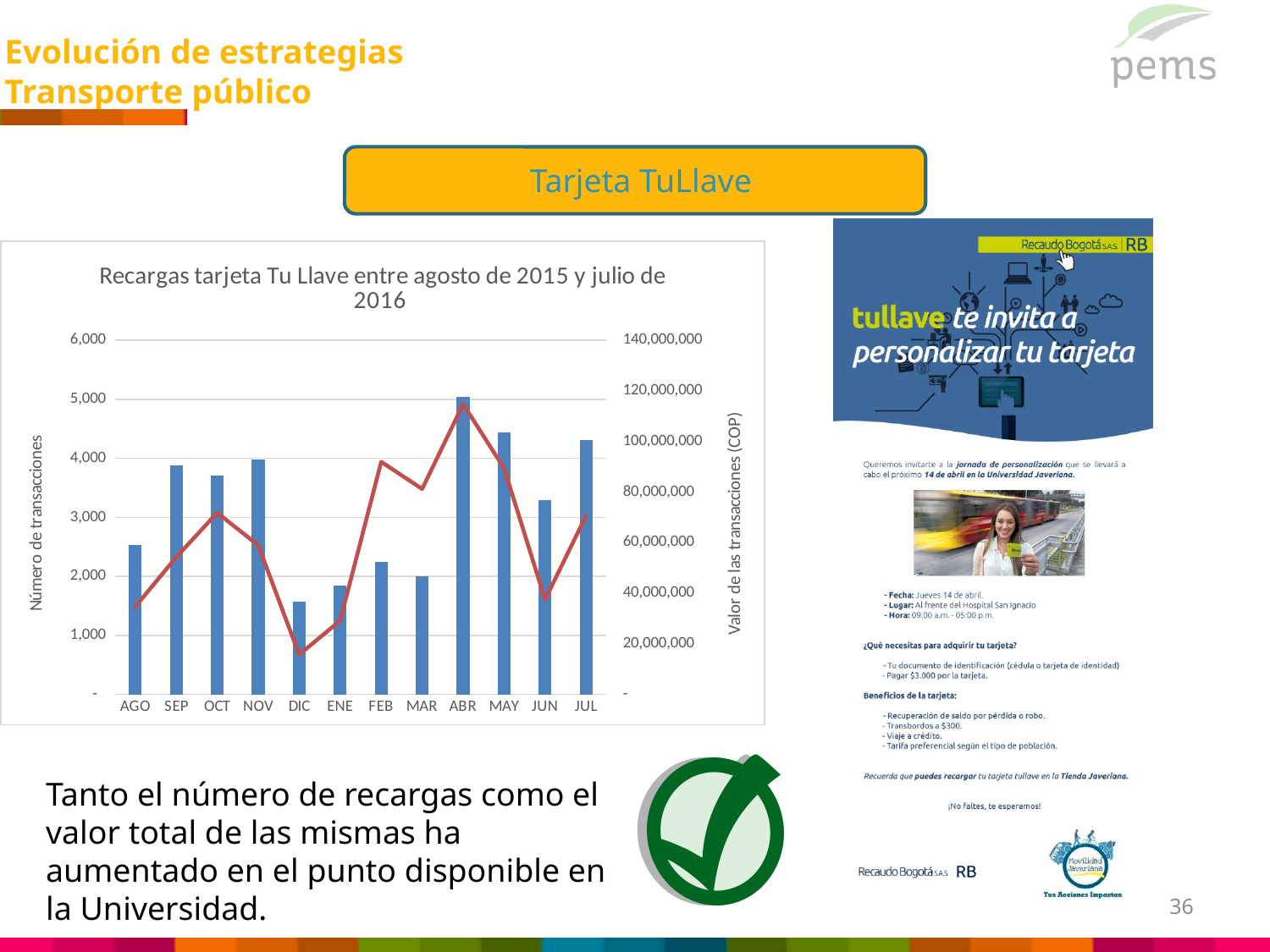
Which month has the highest bar for número de transacciones? ABR What is the title of the chart on the slide? Recargas tarjeta Tu Llave entre agosto de 2015 y julio de 2016 What is the label of the right-hand vertical axis of the chart? Valor de las transacciones (COP) How many months are shown on the x axis of the chart? 12 Is the number of transactions for AGO greater or less than 3,000? less What kind of chart is shown on the slide? A bar chart combined with a line chart Is the number of transactions for DIC greater or less than 2,000? less Which month has the lowest bar for número de transacciones? DIC In which month does the line for valor de las transacciones reach its lowest point? DIC Which month has a higher bar for número de transacciones, MAY or JUN? MAY In which month does the line for valor de las transacciones reach its highest point? ABR